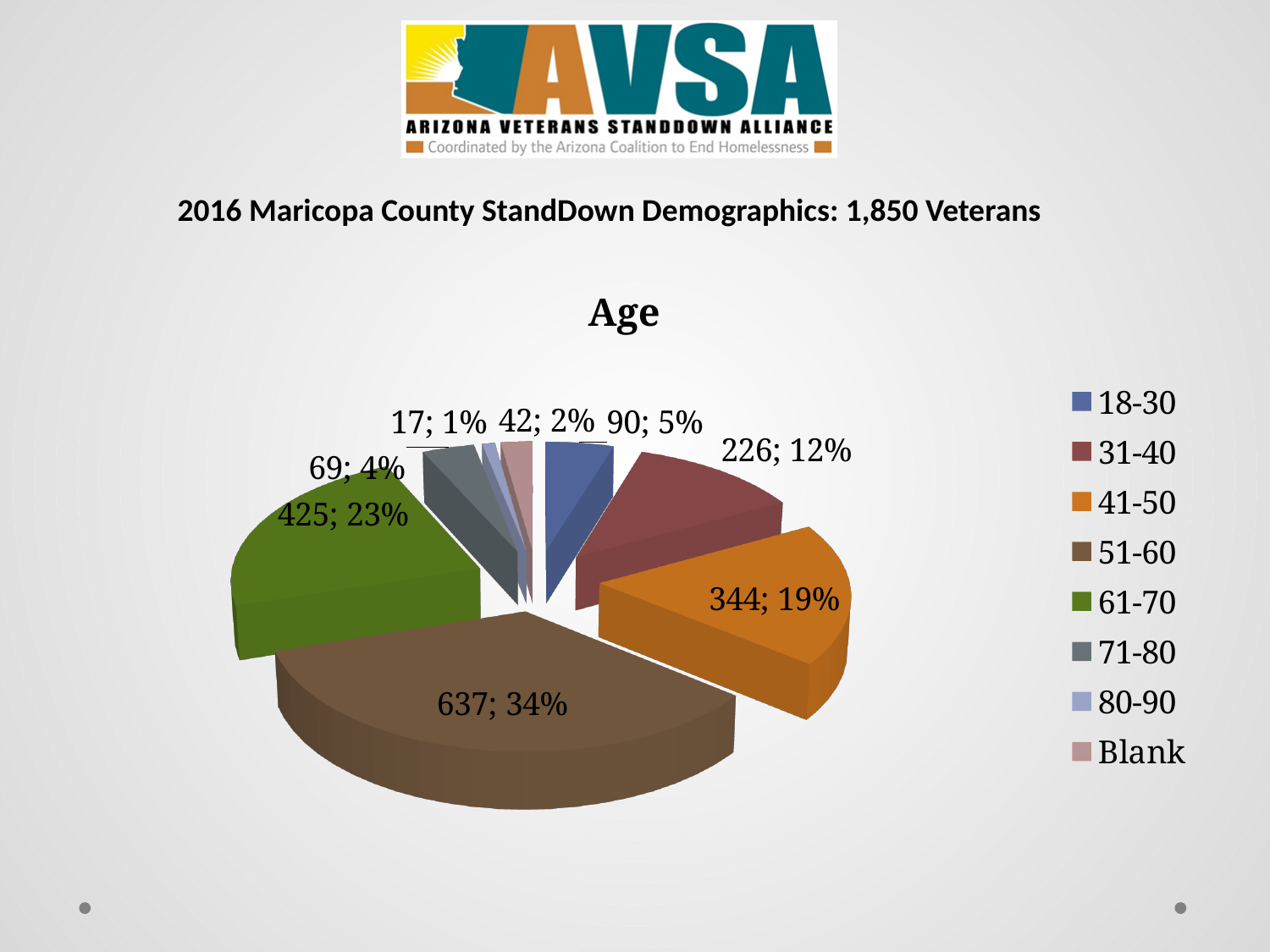
Which category has the smallest slice of the pie? 80-90 What kind of chart is shown on the slide? Pie chart What is the count for the Blank category? 42 What is the count for the 31-40 age group? 226 What percentage share does the 61-70 age group have? 23% Which is larger, the count for 18-30 or the count for 71-80? 18-30 What percentage share does the 41-50 age group have? 19% What is the difference in count between the 51-60 and 61-70 age groups? 212 What is the count for the 51-60 age group? 637 How many categories does the pie chart show? 8 What is the title of the chart? Age Which age group has the largest slice of the pie? 51-60